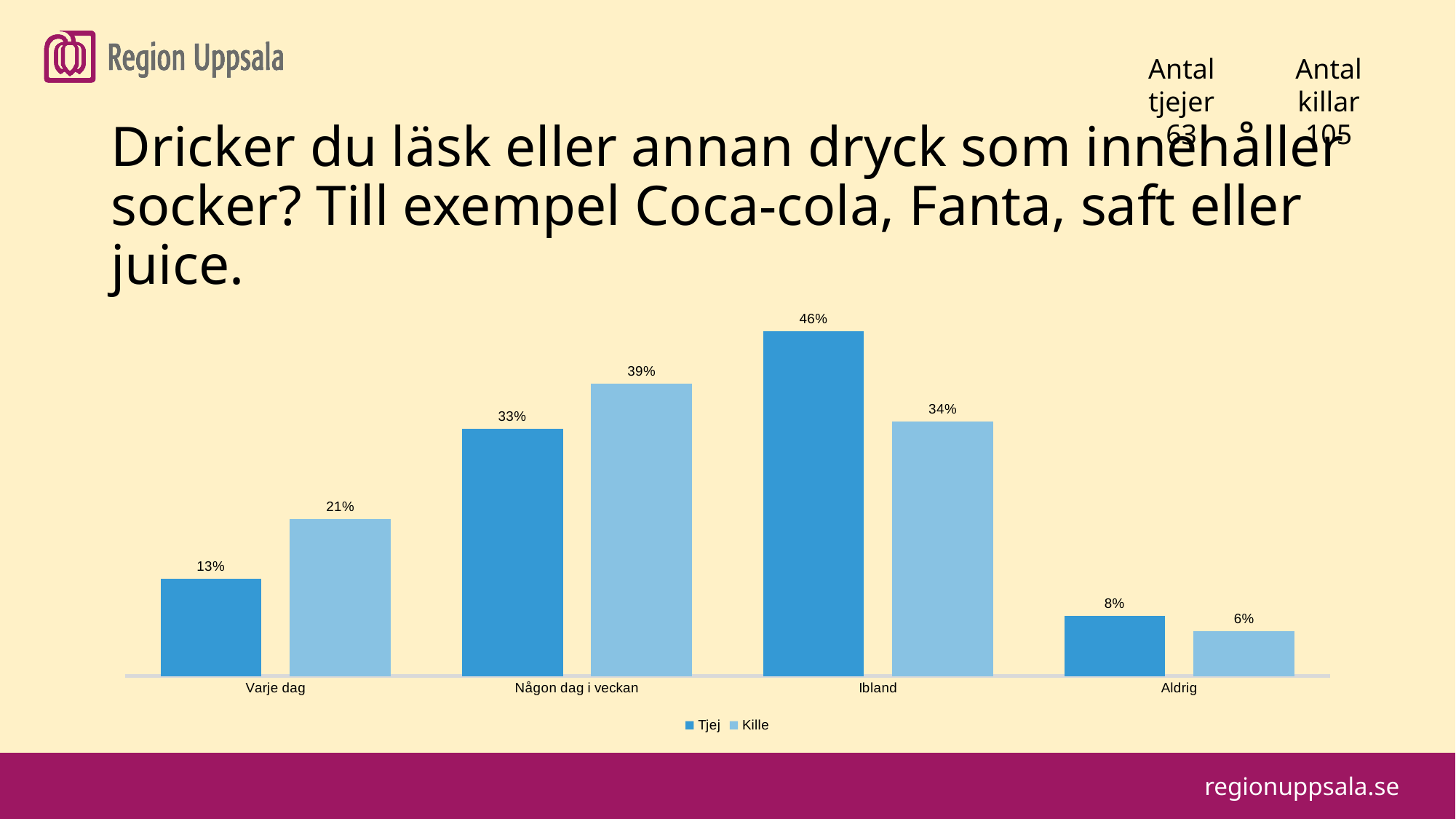
What is the difference between the Kille and Tjej values in the Varje dag category? 8% What is the value for Kille in the Någon dag i veckan category? 39% How many categories are shown on the x axis? 4 Which category has the lowest value for Kille? Aldrig What kind of chart is shown on the slide? Bar chart In the Ibland category, which series has the larger value, Tjej or Kille? Tjej What is the value for Kille in the Aldrig category? 6% Which category has the highest value for Tjej? Ibland What is the value for Tjej in the Varje dag category? 13% How many series does the legend list? 2 What are the two series names listed in the legend? Tjej and Kille What is the value for Tjej in the Ibland category? 46%